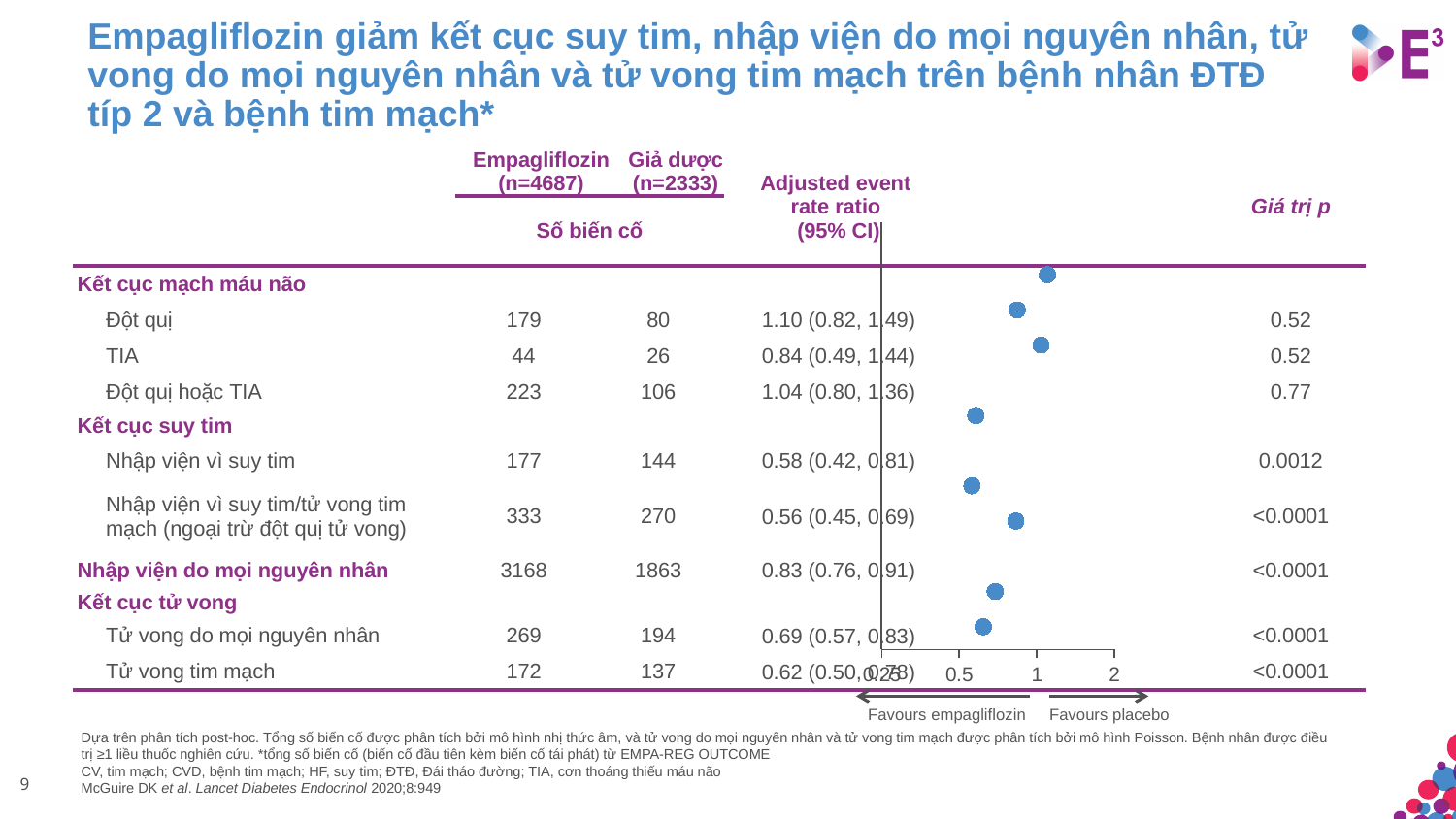
What is the adjusted event rate ratio (95% CI) for Nhập viện vì suy tim? 0.58 (0.42, 0.81) What is the p value (Giá trị p) for Tử vong tim mạch? <0.0001 How many events (Số biến cố) were there in the Empagliflozin group for Đột quị? 179 Which treatment does the left side of the rate ratio axis favour? Favours empagliflozin How many outcomes are plotted as points in the forest plot? 8 What kind of chart is used to display the adjusted event rate ratios? forest plot Which outcome has the highest adjusted event rate ratio? Đột quị What tick values are shown on the rate ratio axis? 0.25, 0.5, 1, 2 Is the adjusted event rate ratio for Tử vong do mọi nguyên nhân greater or less than 1? less What is the difference in the number of events between the Empagliflozin and Giả dược groups for Tử vong tim mạch? 35 Which outcome has the lowest adjusted event rate ratio? Nhập viện vì suy tim/tử vong tim mạch (ngoại trừ đột quị tử vong) Which has the larger adjusted event rate ratio, Đột quị or TIA? Đột quị